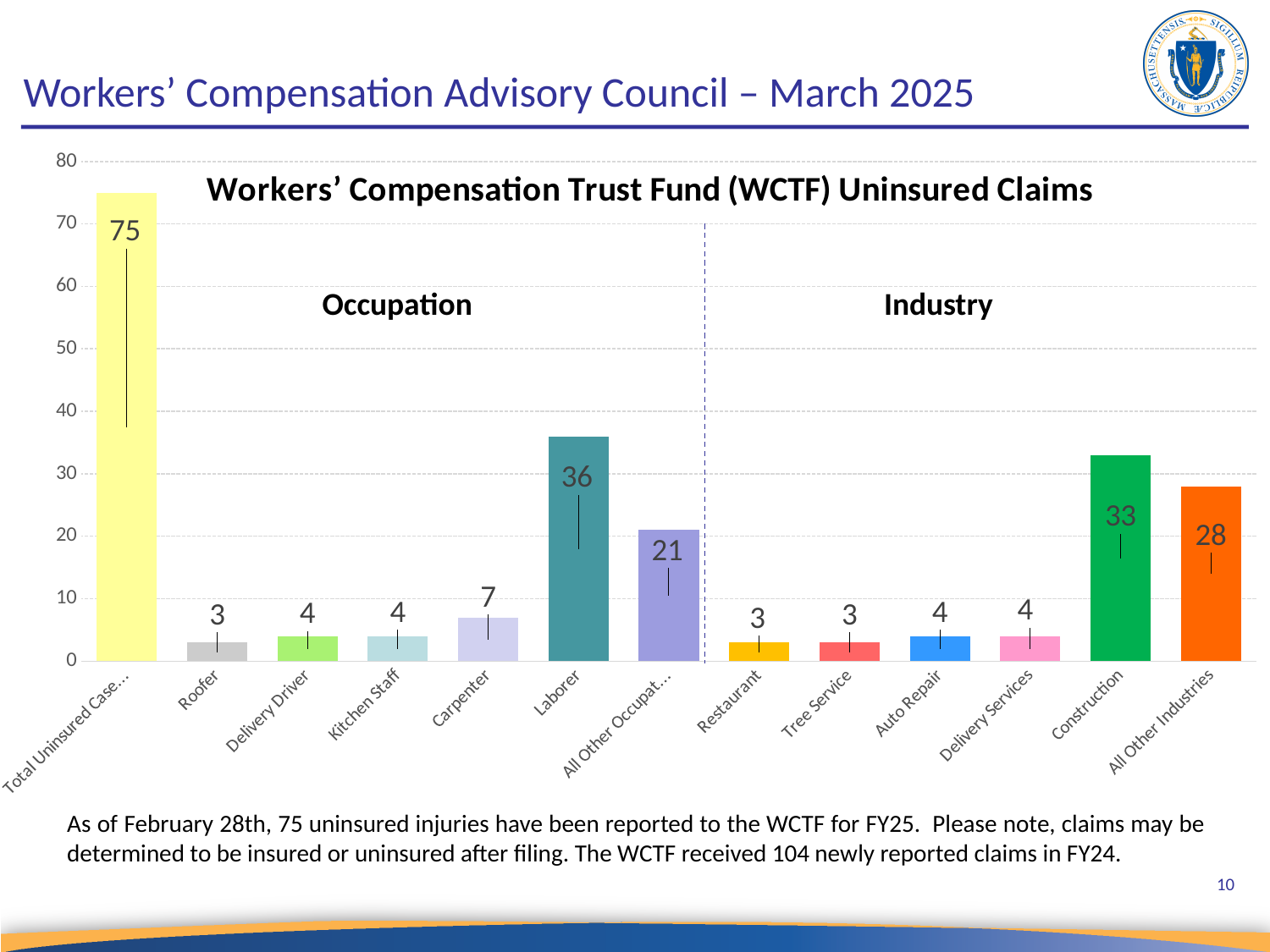
What are the two group labels shown above the bars in the chart? Occupation and Industry What kind of chart is shown on the slide? Bar chart What is the value for Laborer? 36 How many bars are plotted in the chart? 13 Which is larger, the value for Construction or the value for All Other Industries? Construction What is the difference between the values for Laborer and Construction? 3 Which category has the highest value? Total Uninsured Case... Among the Occupation categories (excluding the total bar), which has the highest value? Laborer What is the title of the chart? Workers' Compensation Trust Fund (WCTF) Uninsured Claims What is the value for Construction? 33 What is the value for All Other Industries? 28 What is the value for Carpenter? 7